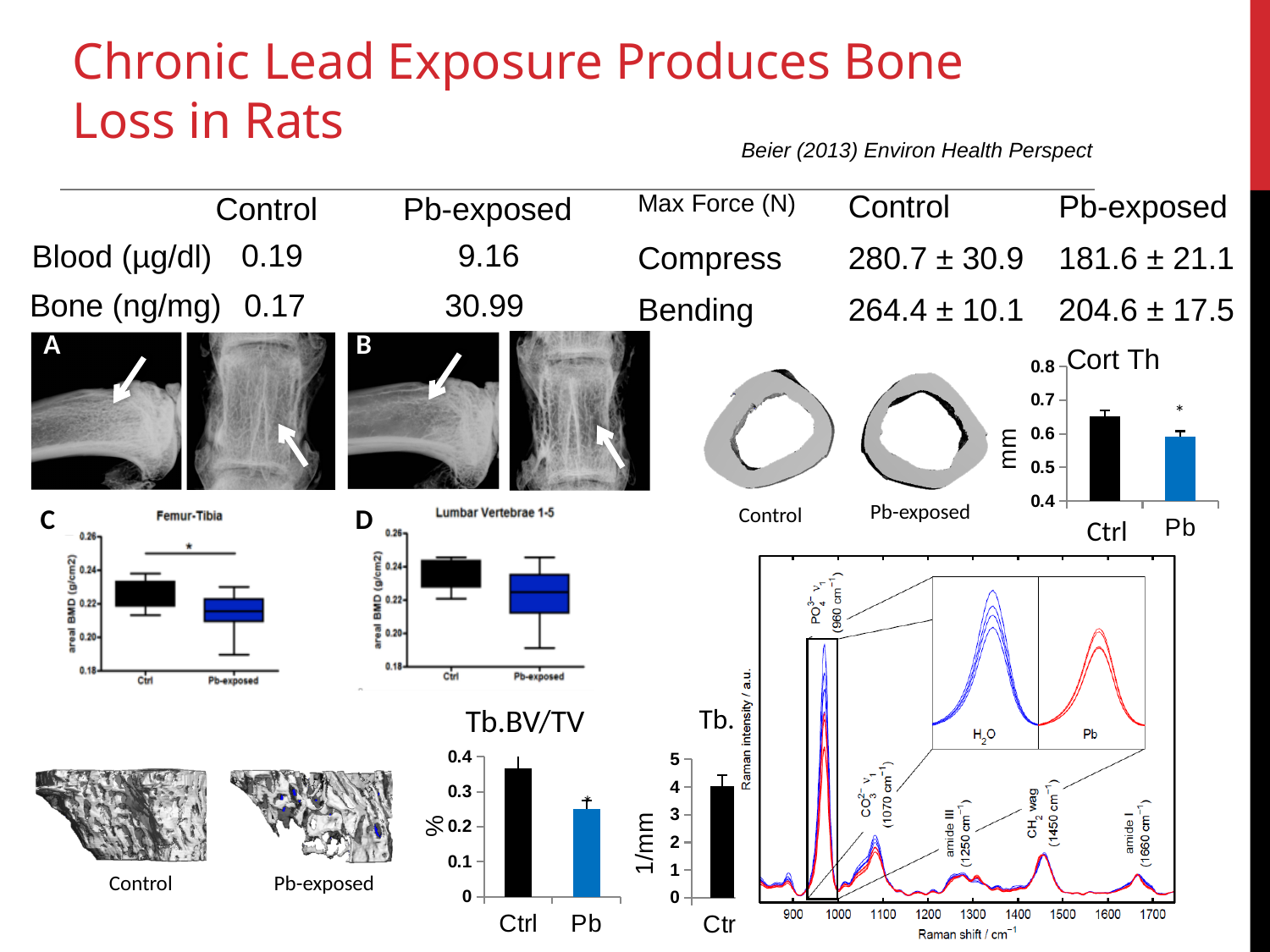
In the Cort Th chart, which bar is taller, Ctrl or Pb? Ctrl In the Femur-Tibia chart (panel C), which group has the higher median areal BMD, Ctrl or Pb-exposed? Ctrl What kind of chart is the Tb.BV/TV chart? bar chart In the Tb. chart with the 1/mm y axis, is the value for Ctr greater or less than 3? greater In the Cort Th chart, is the value for Pb greater or less than 0.7? less In the Tb.BV/TV chart, is the value for Ctrl greater or less than 0.3? greater How many categories are shown on the x axis of the Tb.BV/TV chart? 2 In the Tb.BV/TV chart, which category has the lowest value? Pb What unit is shown on the y axis of the Cort Th chart? mm What is the x axis label of the Raman spectrum chart? Raman shift / cm⁻¹